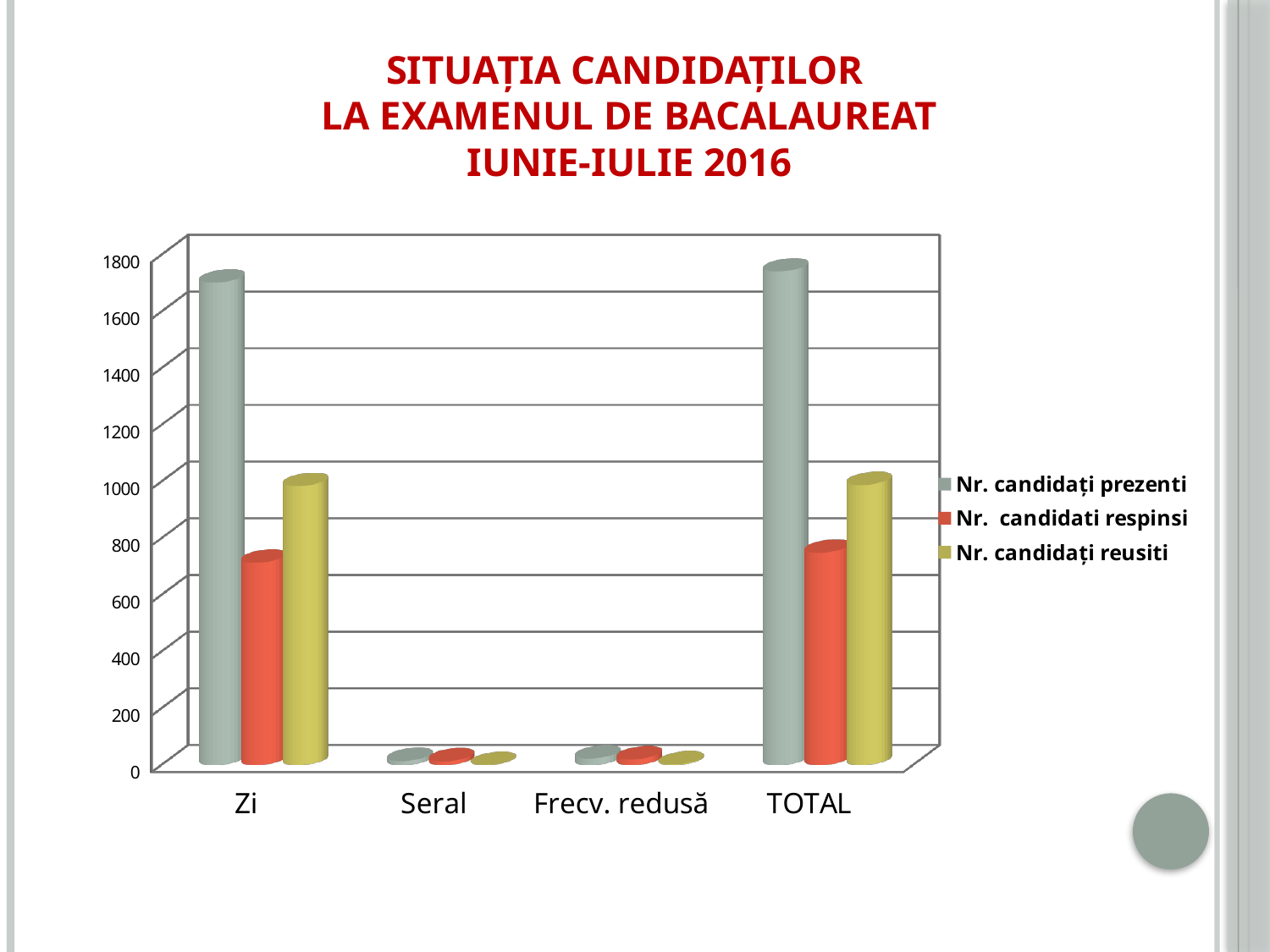
Which colour represents Nr. candidati respinsi in the chart's legend? red Is the value of Nr. candidați prezenti for Zi greater or less than 1600? greater What kind of chart is shown on the slide? bar chart How many series does the chart's legend list? 3 Is the value of Nr. candidați prezenti for Seral greater or less than 200? less How many categories are shown on the x axis of the chart? 4 Is the value of Nr. candidati respinsi for TOTAL greater or less than 1000? less For the TOTAL category, which is larger: Nr. candidați prezenti or Nr. candidați reusiti? Nr. candidați prezenti For the Zi category, which is larger: Nr. candidati respinsi or Nr. candidați reusiti? Nr. candidați reusiti